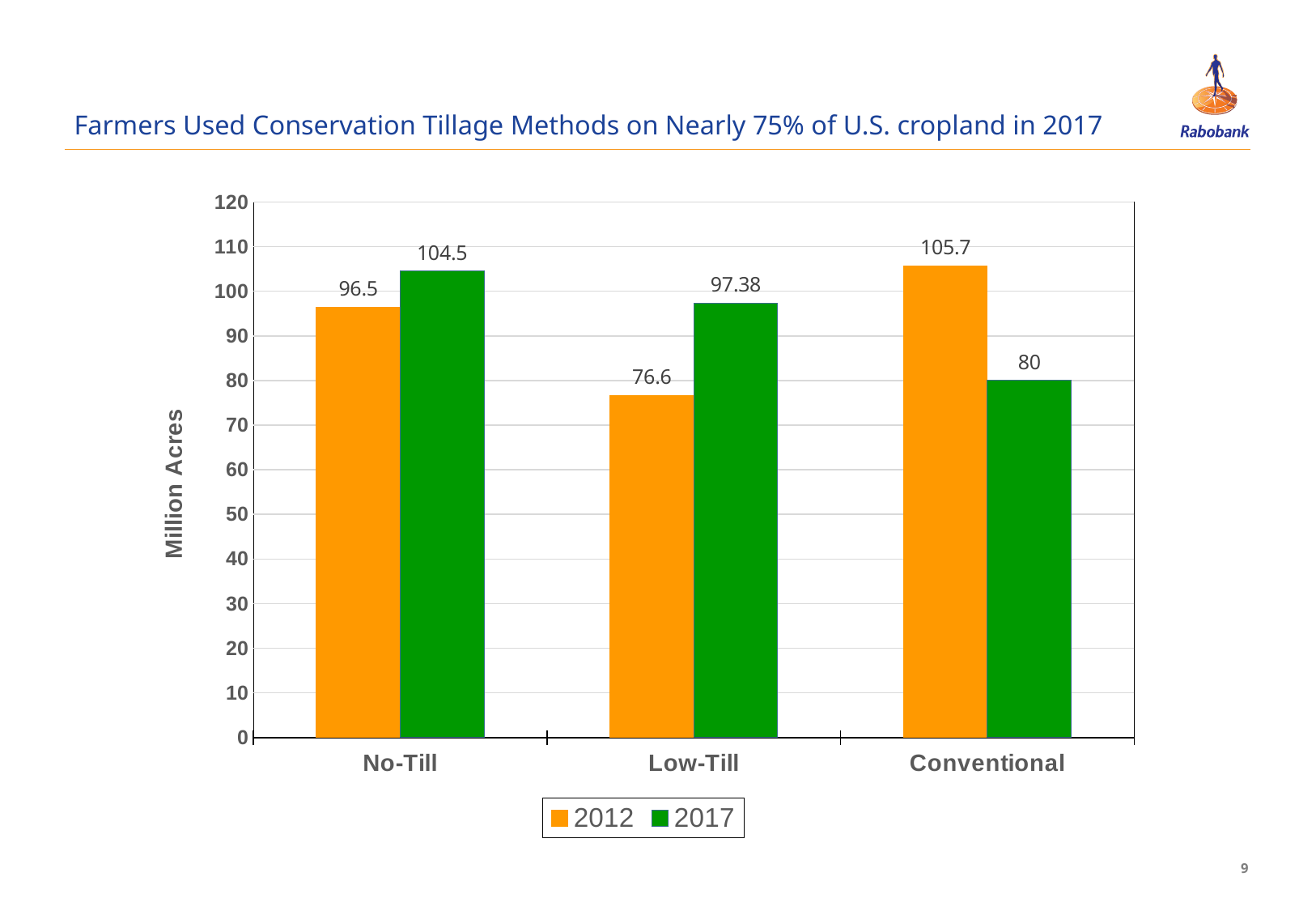
What is the difference between the 2017 and 2012 values for Low-Till? 20.78 What was the Conventional value in 2017? 80 Is the 2012 value for No-Till greater or less than 90? greater Which tillage method had the lowest value in 2017? Conventional How many tillage method categories are shown on the x axis? 3 What is the label on the vertical axis? Million Acres What was the Low-Till value in 2012? 76.6 How many series does the legend list? 2 What was the No-Till value in 2017? 104.5 Which is larger for Conventional: the 2012 value or the 2017 value? 2012 What kind of chart is shown on the slide? Bar chart Which tillage method had the highest value in 2012? Conventional